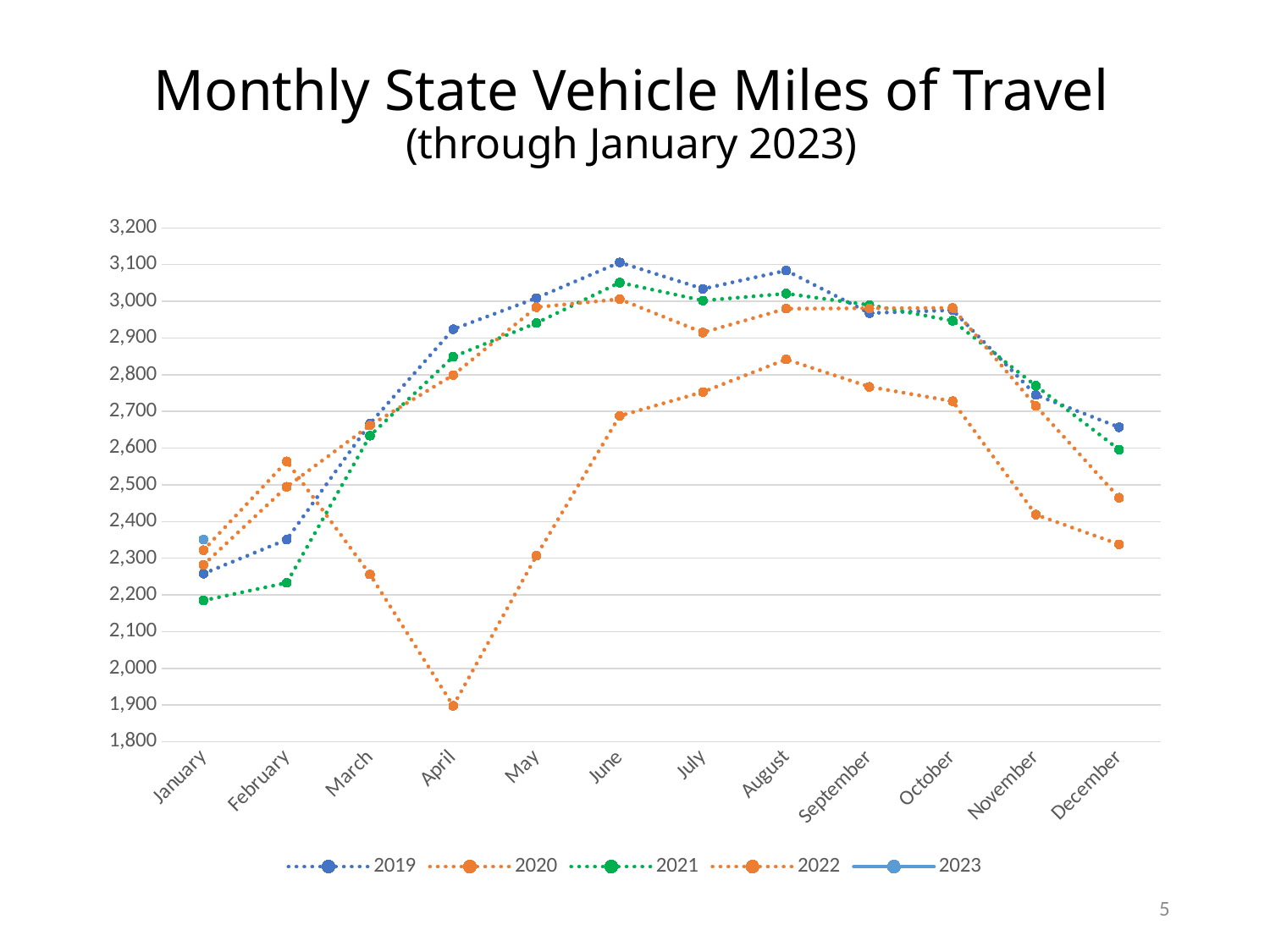
In June, which series has the larger value, 2019 or 2021? 2019 What kind of chart is shown on the slide? line chart Does the 2021 series rise or fall from October to December? fall Which series is drawn with a solid line rather than a dotted line? 2023 Is the value for 2023 in January greater or less than 2,300? greater How many months are shown along the x axis? 12 Is the value for 2019 in December greater or less than 2,600? greater In which month does the lowest point on the chart occur? April Is the value for 2021 in January greater or less than 2,300? less How many series does the legend list? 5 Does the 2019 series rise or fall from January to June? rise